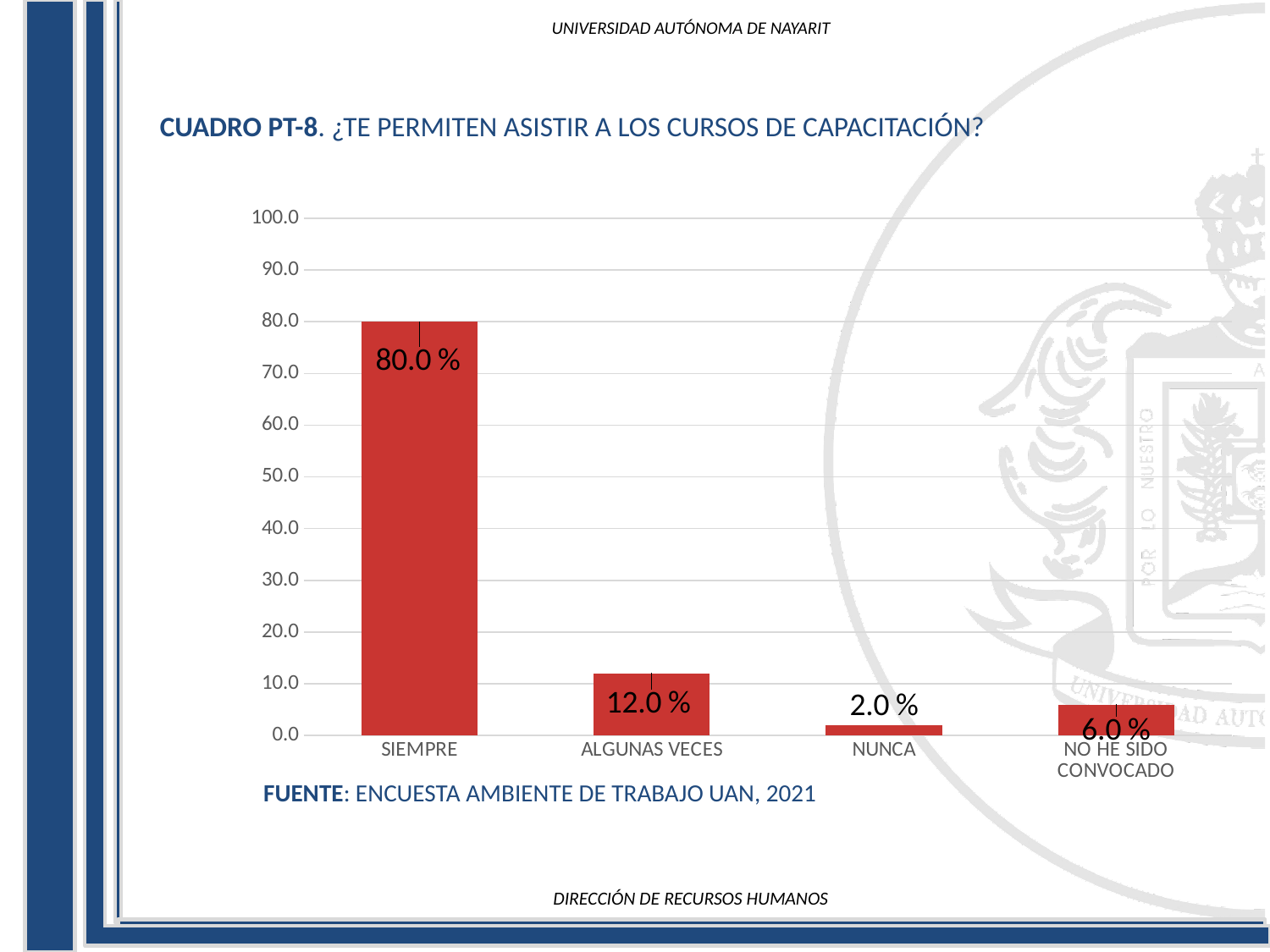
What is the source cited below the chart? ENCUESTA AMBIENTE DE TRABAJO UAN, 2021 What kind of chart is shown on the slide? bar chart What is the value for SIEMPRE? 80.0 % Which category has the lowest value? NUNCA How many categories are shown on the x axis? 4 What is the difference between the values for SIEMPRE and ALGUNAS VECES? 68.0 % What is the difference between the values for NO HE SIDO CONVOCADO and NUNCA? 4.0 % Which category has the highest value? SIEMPRE What is the value for NO HE SIDO CONVOCADO? 6.0 % Which is larger, the value for ALGUNAS VECES or the value for NO HE SIDO CONVOCADO? ALGUNAS VECES What is the value for NUNCA? 2.0 % What is the value for ALGUNAS VECES? 12.0 %